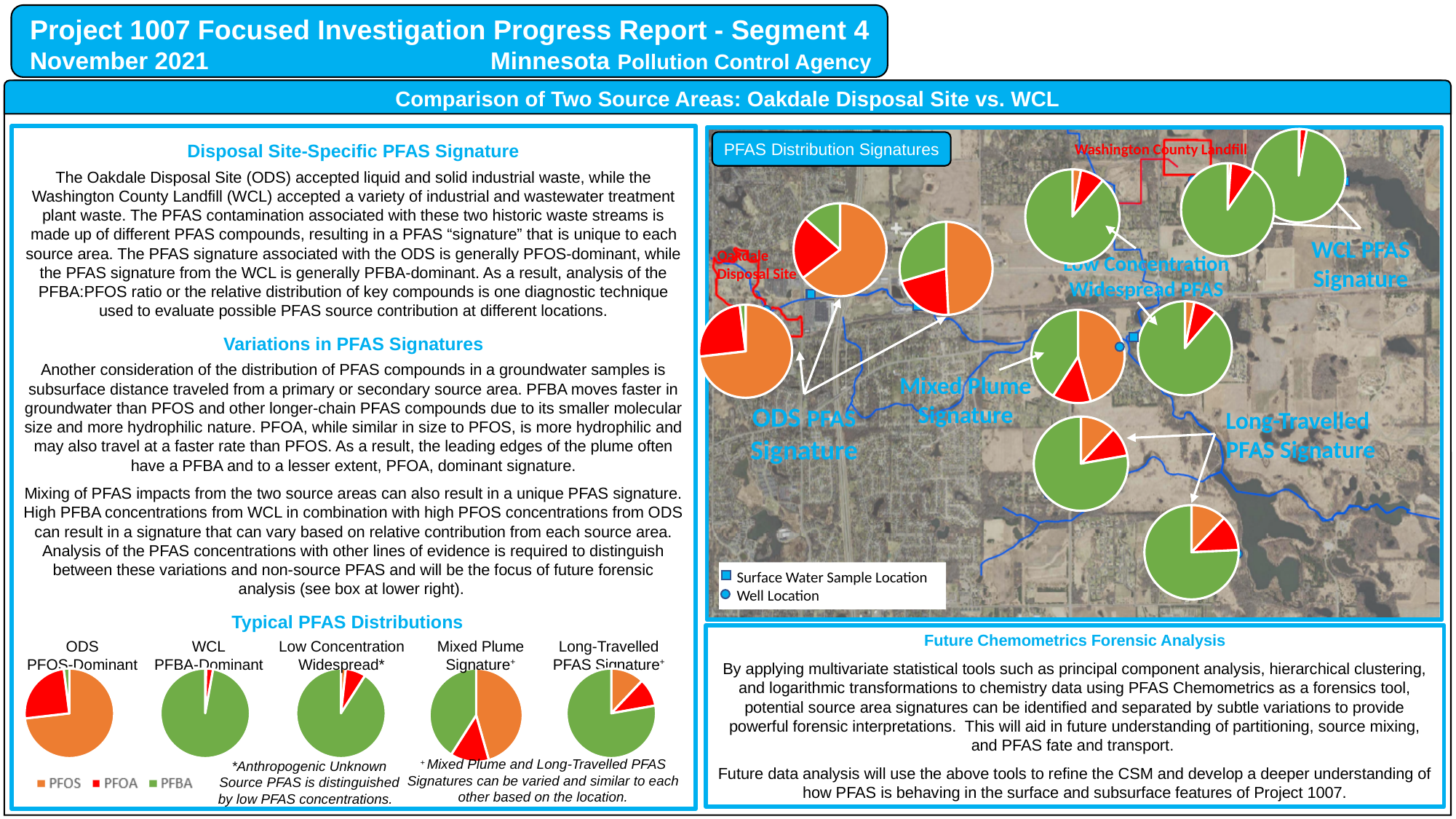
In the Long-Travelled PFAS Signature pie chart, which compound has the largest slice? PFBA In the ODS PFOS-Dominant pie chart, which compound has the largest slice? PFOS What colour represents PFBA in the Typical PFAS Distributions legend? Green How many pie charts are shown in the Typical PFAS Distributions section? 5 How many compounds does the legend under the Typical PFAS Distributions charts list? 3 In the WCL PFBA-Dominant pie chart, which compound has the largest slice? PFBA What kind of chart is used in the Typical PFAS Distributions section? Pie chart In the ODS PFOS-Dominant pie chart, which slice is larger, PFOA or PFBA? PFOA In the ODS PFOS-Dominant pie chart, which compound has the smallest slice? PFBA In the Mixed Plume Signature pie chart, which slice is larger, PFOS or PFBA? PFOS Which compound is shown in red in the Typical PFAS Distributions legend? PFOA